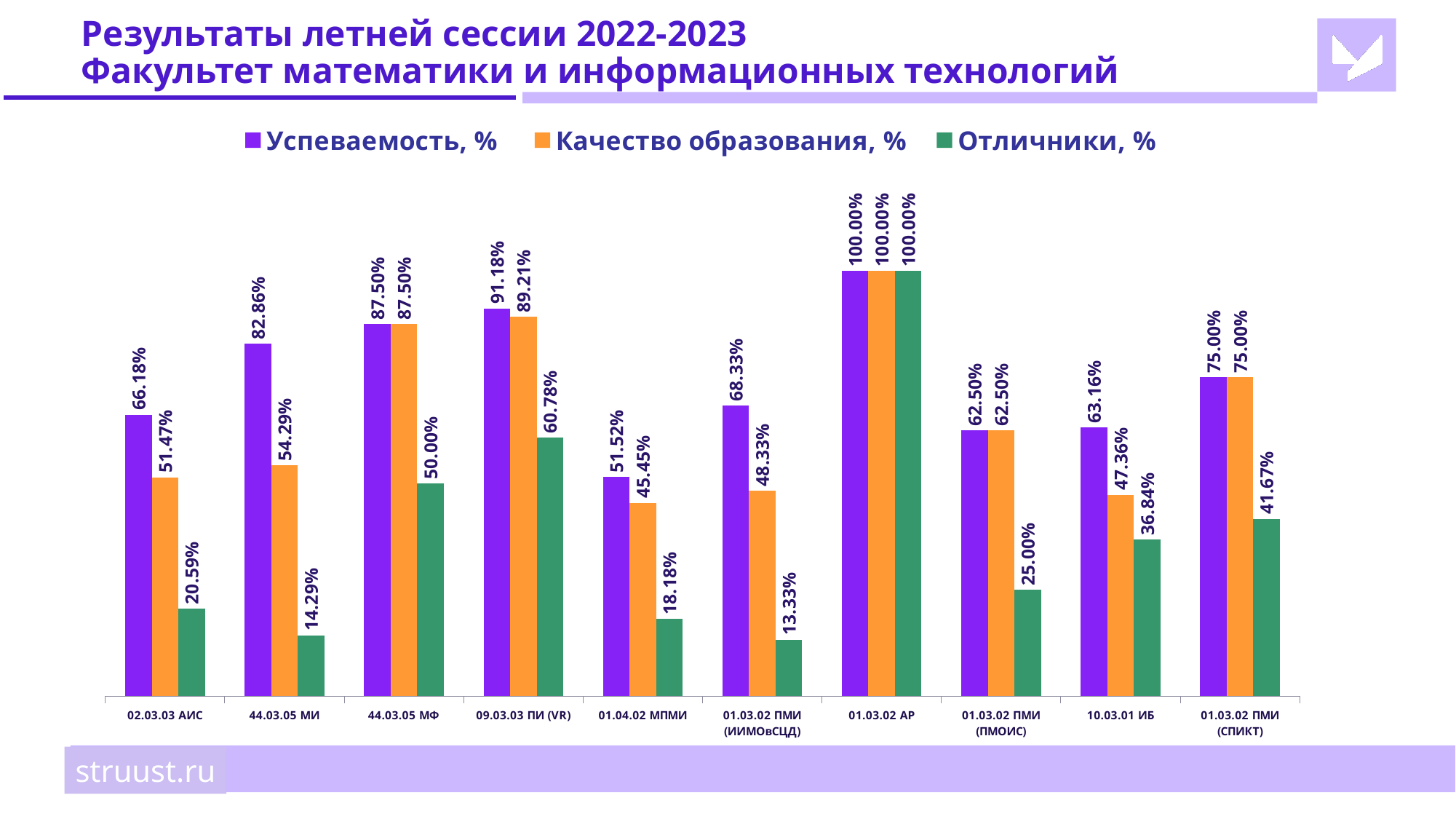
What is the value of Отличники, % for 01.03.02 ПМИ (ИИМОвСЦД)? 13.33% How many series does the legend list? 3 What is the difference between Отличники, % for 09.03.03 ПИ (VR) and for 44.03.05 МФ? 10.78% What is the value of Успеваемость, % for 09.03.03 ПИ (VR)? 91.18% What type of chart is shown on the slide? bar chart Which category has the lowest value of Успеваемость, %? 01.04.02 МПМИ What is the value of Качество образования, % for 10.03.01 ИБ? 47.36% Which category has the highest value of Отличники, %? 01.03.02 АР How many categories (programmes) are shown on the x axis? 10 Which series is shown in green in the legend? Отличники, % Which is larger: Отличники, % for 10.03.01 ИБ or for 01.03.02 ПМИ (ПМОИС)? 10.03.01 ИБ What is the difference between Успеваемость, % and Качество образования, % for 44.03.05 МИ? 28.57%